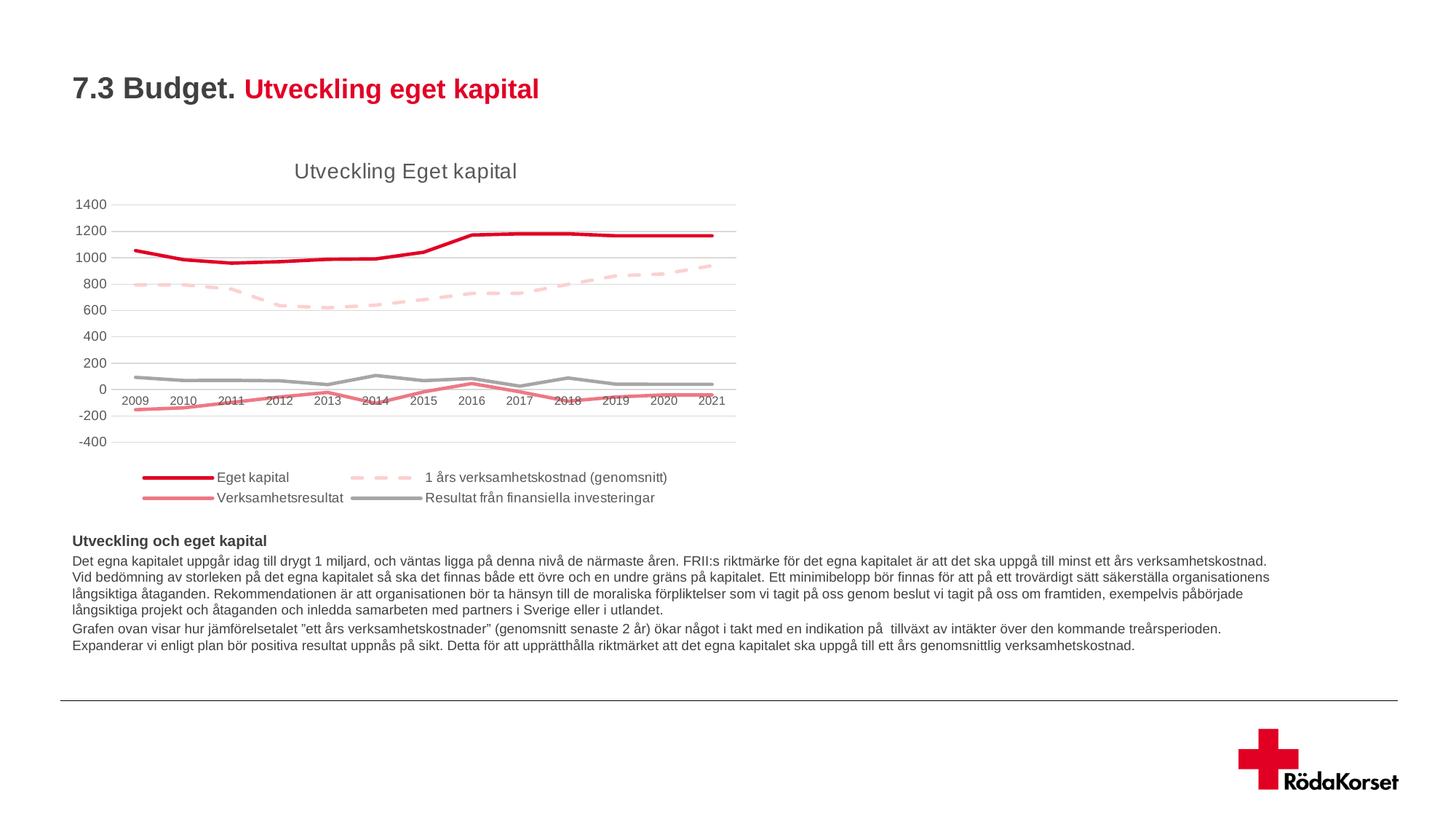
Is the value of 1 års verksamhetskostnad (genomsnitt) in 2013 greater or less than 800? less What is the title of the chart? Utveckling Eget kapital Which series in the chart is drawn with a dashed line? 1 års verksamhetskostnad (genomsnitt) In 2013, which is larger: Eget kapital or 1 års verksamhetskostnad (genomsnitt)? Eget kapital Does the 1 års verksamhetskostnad (genomsnitt) line rise or fall from 2013 to 2021? Rise How many series does the legend of the chart list? 4 How many years are shown on the x axis of the chart? 13 Is the value of Eget kapital in 2016 greater or less than 1000? greater Is the value of Verksamhetsresultat in 2009 greater or less than 0? less In which year is the 1 års verksamhetskostnad (genomsnitt) line at its highest? 2021 What kind of chart is shown on the slide? Line chart